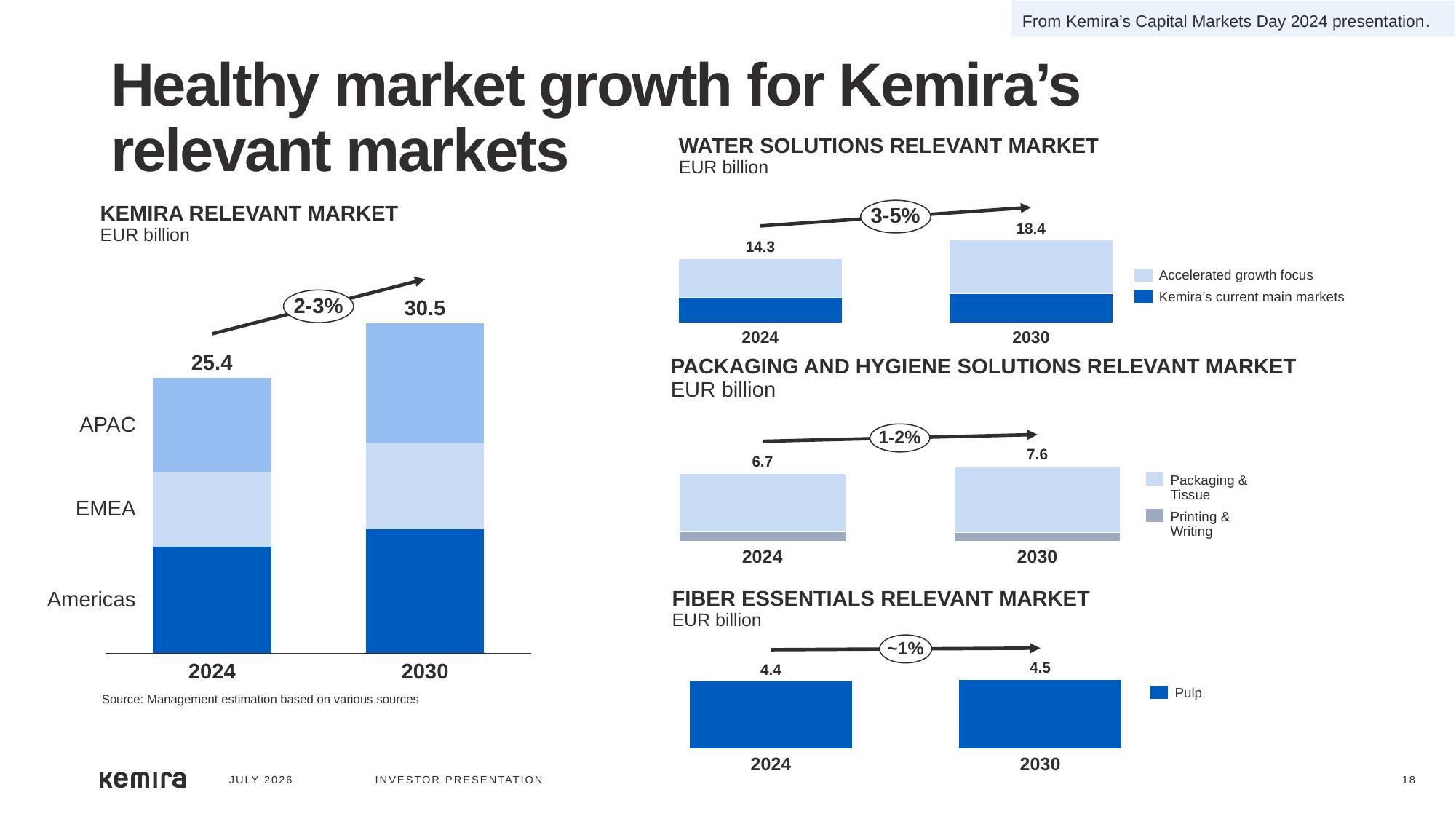
In the Kemira Relevant Market chart, what is the difference between the 2030 and 2024 totals? 5.1 In the Water Solutions Relevant Market chart, what is the difference between the 2030 and 2024 values? 4.1 What type of chart is the Kemira Relevant Market chart? Stacked bar chart In the Packaging and Hygiene Solutions Relevant Market chart, what is the value for 2030? 7.6 In the Fiber Essentials Relevant Market chart, what is the difference between the 2030 and 2024 values? 0.1 In the Water Solutions Relevant Market chart, what is the value for 2024? 14.3 In the Kemira Relevant Market chart, what is the total value for 2030? 30.5 In the Fiber Essentials Relevant Market chart, what is the value for 2024? 4.4 In the Packaging and Hygiene Solutions Relevant Market chart, which segment is larger in 2024, Packaging & Tissue or Printing & Writing? Packaging & Tissue In the Kemira Relevant Market chart, what is the total value for 2024? 25.4 In the Water Solutions Relevant Market chart, how many series does the legend list? 2 In the Kemira Relevant Market chart, how many regional segments make up each stacked bar? 3